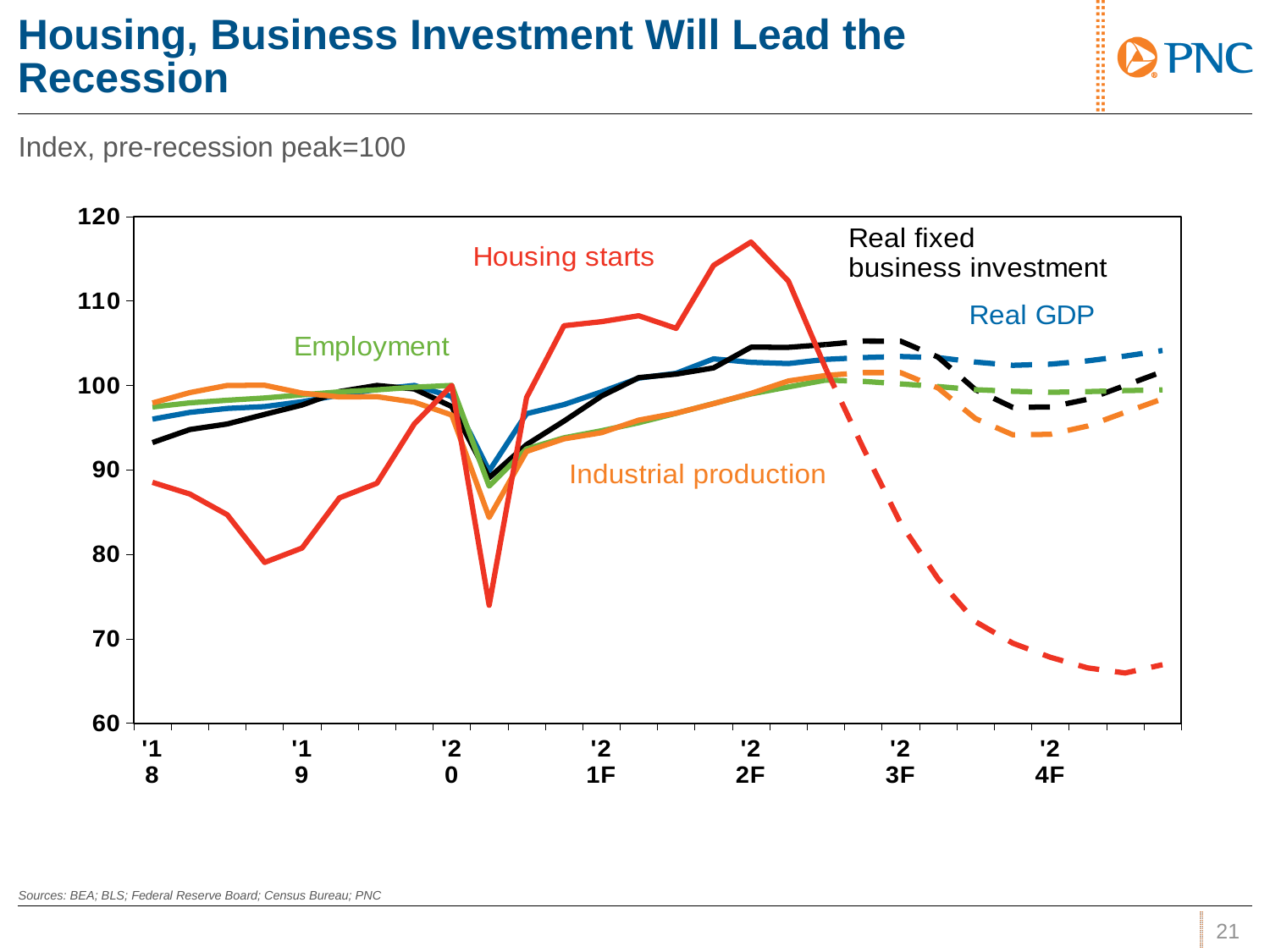
How many series are plotted on the chart? 5 Which series has the lowest value at the right end of the chart ('24F)? Housing starts Is the value for Real GDP at the right end of the chart greater or less than 100? greater What kind of chart is shown on the slide? line chart How many year labels are shown on the x axis? 7 Which series has the lowest value in 2020? Housing starts Which series reaches the highest value on the chart? Housing starts What index base is stated in the subtitle of the chart? Index, pre-recession peak=100 Is the peak value for Housing starts in '22F greater or less than 110? greater Is the value for Housing starts at the right end of the chart greater or less than 70? less Do the values for Housing starts rise or fall from '22F to '24F? fall